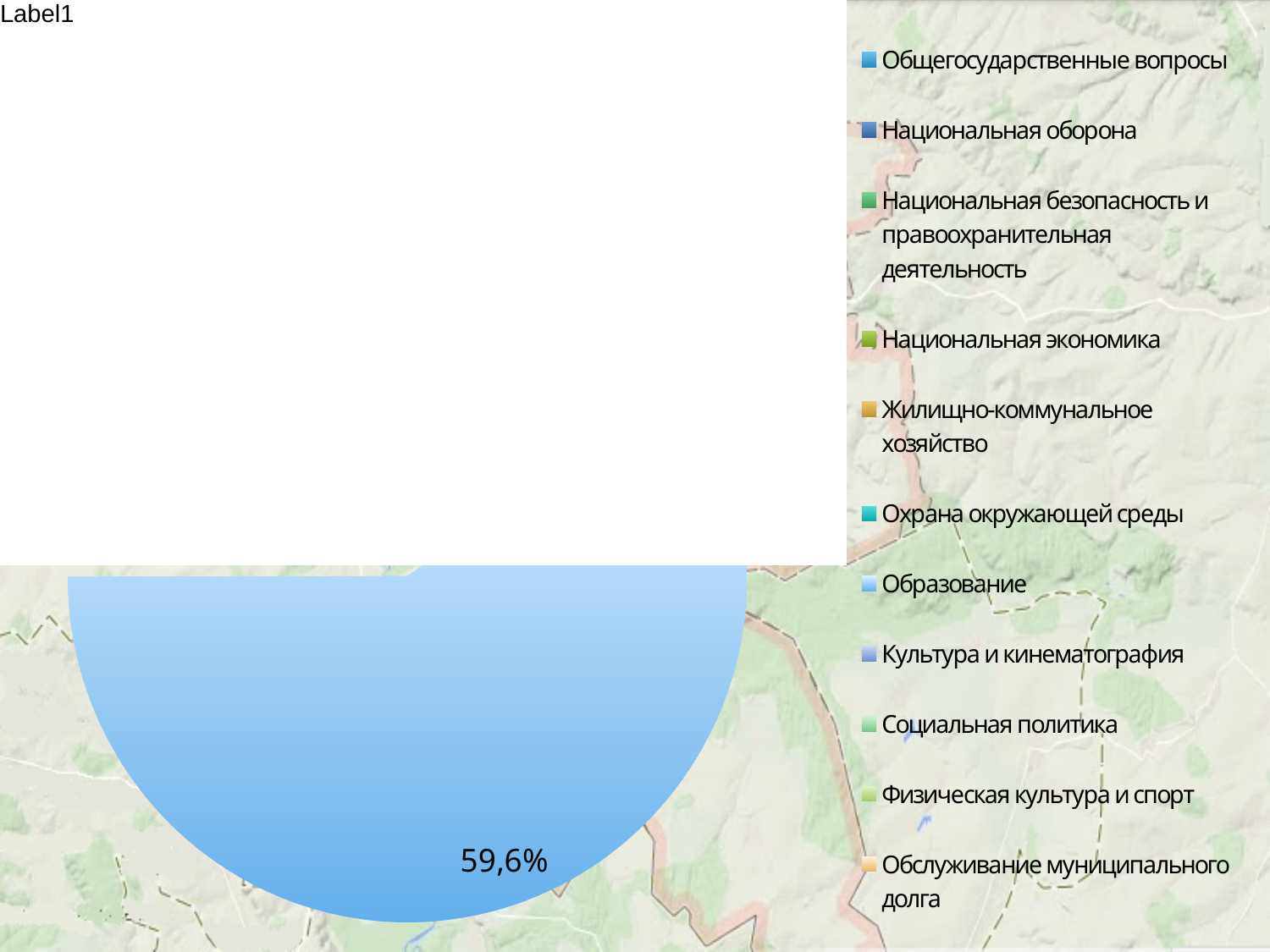
What percentage label is printed on the large visible slice of the pie chart? 59,6% Is the slice labelled 59,6% greater or less than half of the pie? greater How many categories does the legend of the pie chart list? 11 What is the first entry listed in the pie chart's legend? Общегосударственные вопросы What is the last entry listed in the pie chart's legend? Обслуживание муниципального долга What kind of chart is shown on the slide? pie chart What title text appears at the top left of the chart? Label1